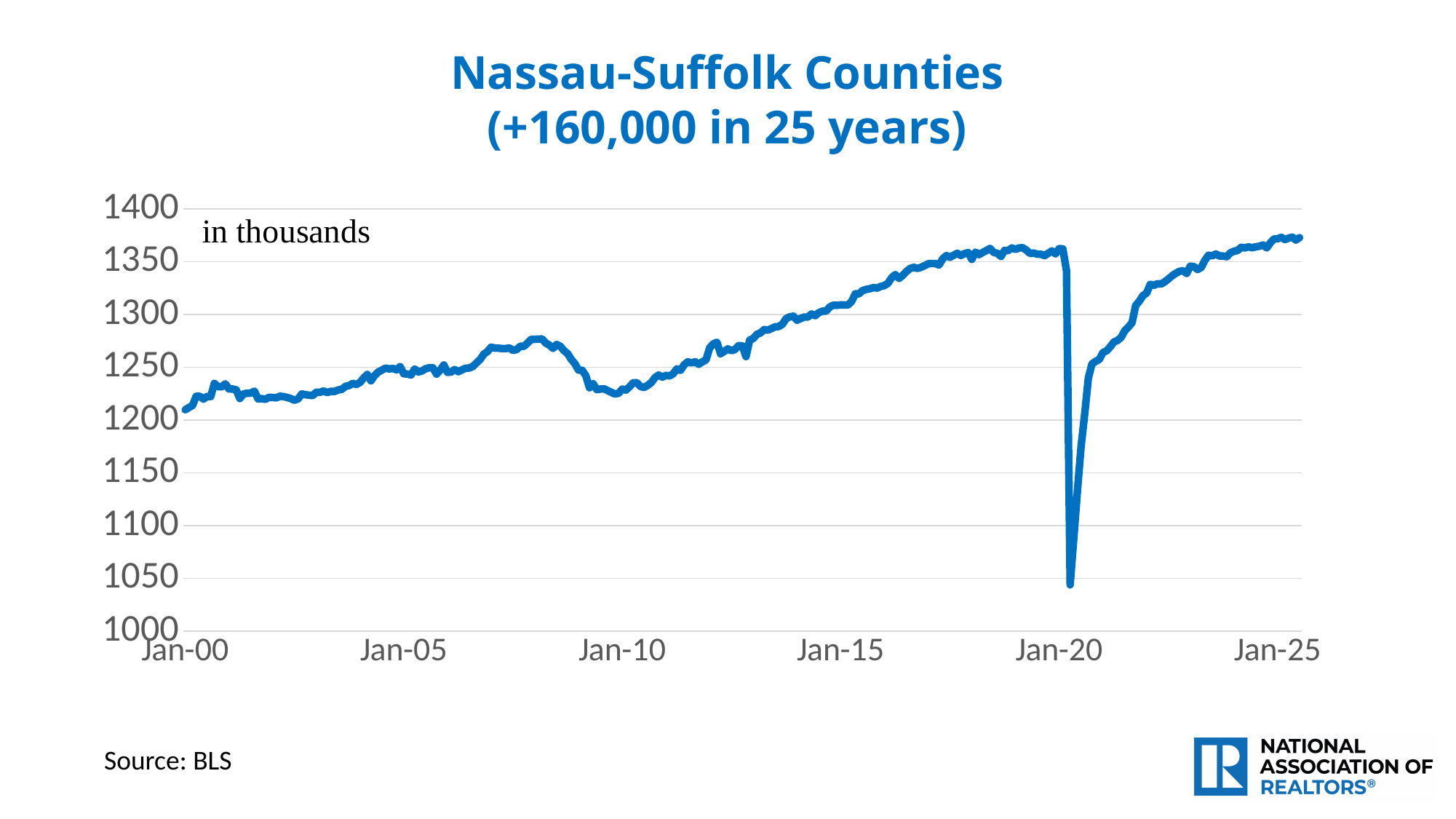
Is the value at Jan-15 greater or less than 1300? greater What is the title of the chart? Nassau-Suffolk Counties (+160,000 in 25 years) What kind of chart is shown on the slide? line chart Is the value at Jan-10 greater or less than 1250? less Which is larger, the value at Jan-05 or the value at Jan-25? Jan-25 Is the value at Jan-25 greater or less than 1350? greater In what units are the values on the chart expressed? in thousands Overall, do the values rise or fall from Jan-00 to Jan-25? rise How many lines (series) are plotted on the chart? 1 Around which year does the line reach its lowest point? 2020